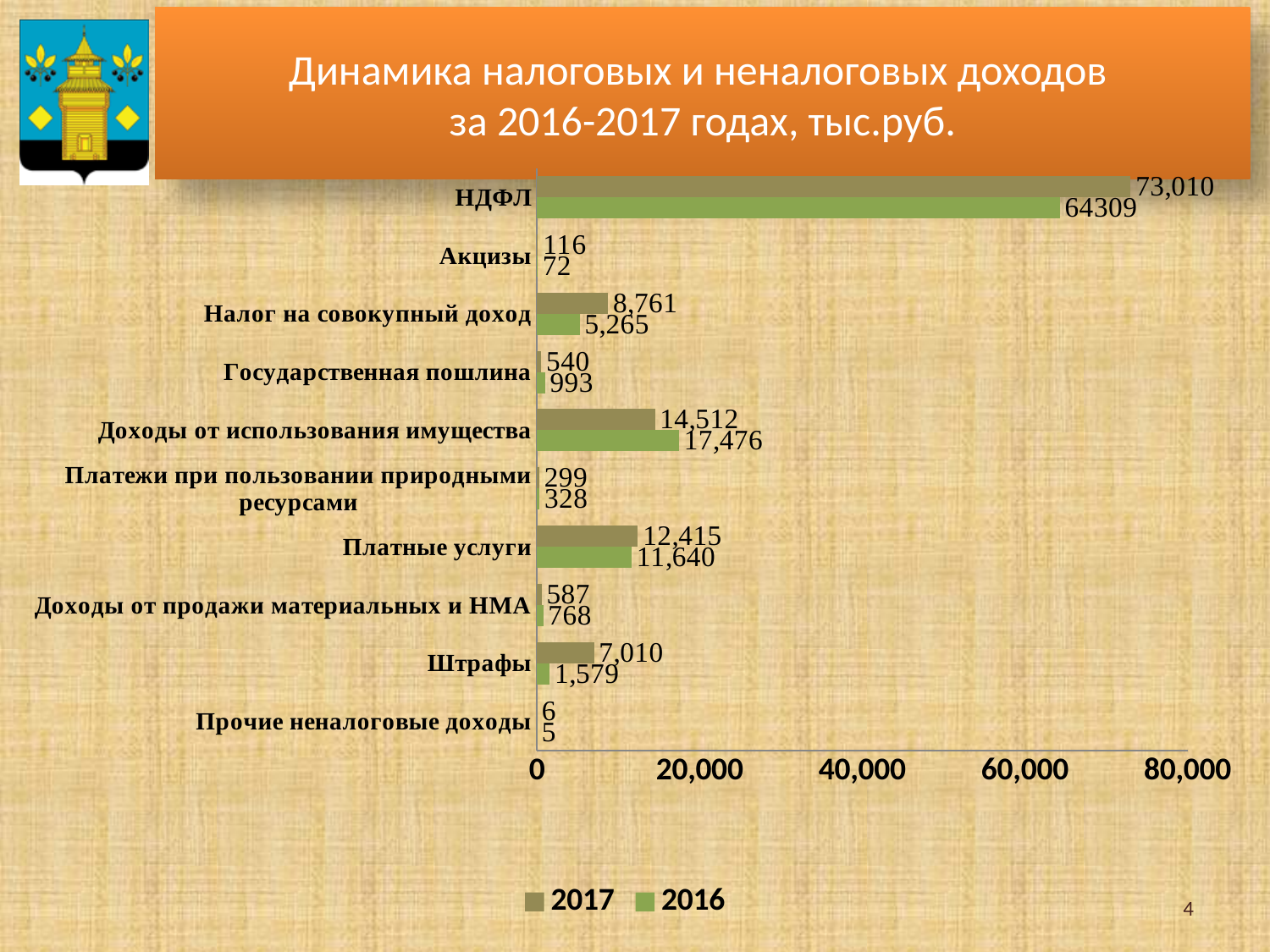
What is the value for Штрафы in 2016? 1,579 Which category has the lowest value in 2016? Прочие неналоговые доходы Is the 2016 value for НДФЛ greater or less than 60,000? greater What is the value for Доходы от использования имущества in 2017? 14,512 What is the value for НДФЛ in 2017? 73,010 What is the difference between the 2017 and 2016 values for Налог на совокупный доход? 3,496 Which is larger for Государственная пошлина: the 2016 value or the 2017 value? 2016 Which category has the highest value in 2017? НДФЛ What kind of chart is shown on the slide? Bar chart What is the value for НДФЛ in 2016? 64309 How many series does the legend list? 2 How many categories are shown on the chart? 10